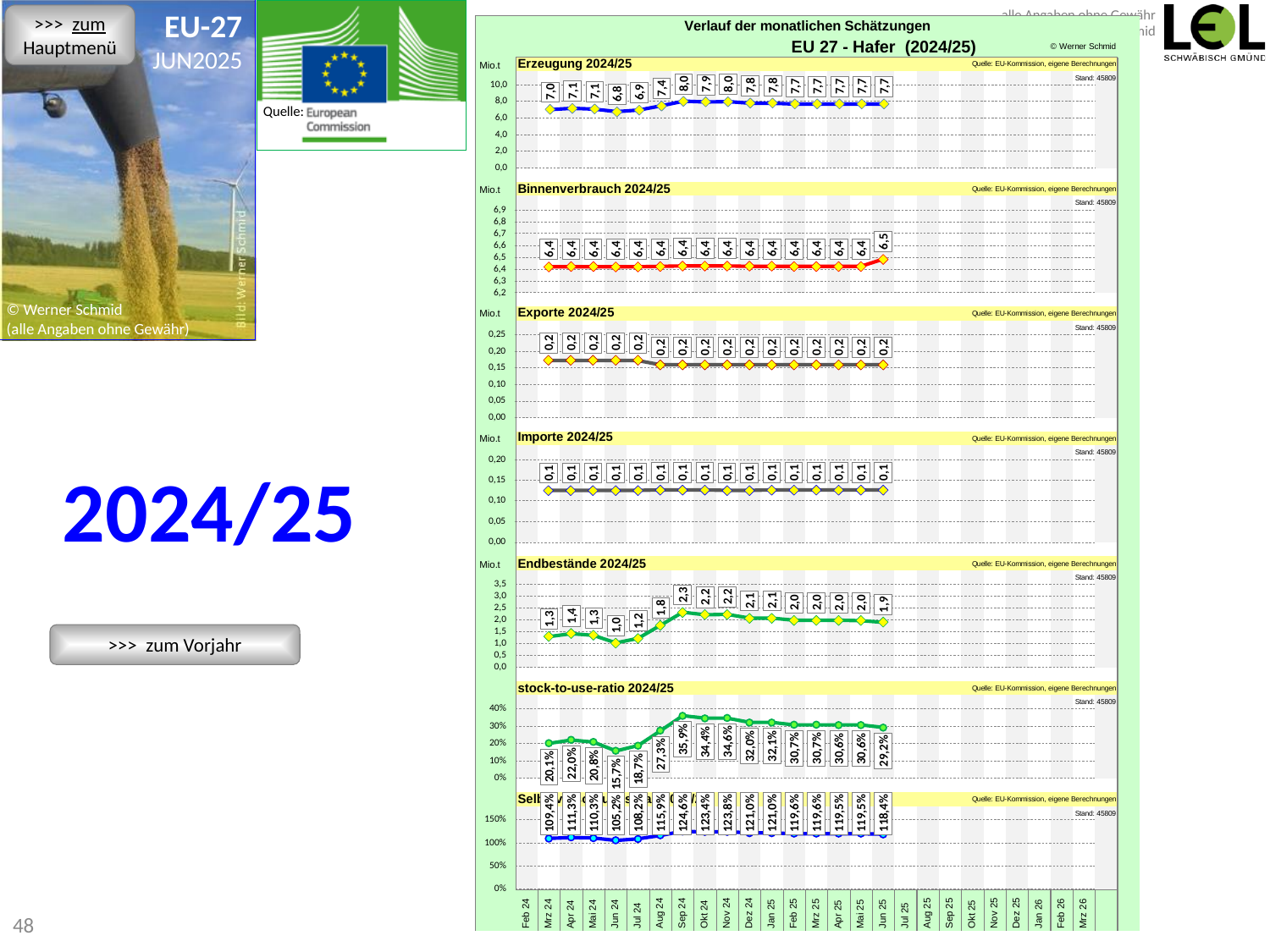
In the 'Endbestände 2024/25' chart, what is the difference between the highest value (2,3) and the lowest value (1,0)? 1,3 In the 'Binnenverbrauch 2024/25' chart, what is the value for Jun 25? 6,5 In the bottom chart of the slide (values in percent above 100%), what is the latest value shown (Jun 25)? 118,4% What type of chart is used for 'Erzeugung 2024/25'? Line chart In the 'Endbestände 2024/25' chart, what is the highest value plotted? 2,3 In the 'Erzeugung 2024/25' chart, what is the lowest value plotted? 6,8 In the 'stock-to-use-ratio 2024/25' chart, what is the lowest value plotted? 15,7% In the 'Erzeugung 2024/25' chart, what is the highest value plotted? 8,0 In the 'Endbestände 2024/25' chart, what is the lowest value plotted? 1,0 In the 'Erzeugung 2024/25' chart, what is the latest value shown (Jun 25)? 7,7 In the 'stock-to-use-ratio 2024/25' chart, what is the latest value shown (Jun 25)? 29,2% In the 'stock-to-use-ratio 2024/25' chart, what is the highest value plotted? 35,9%